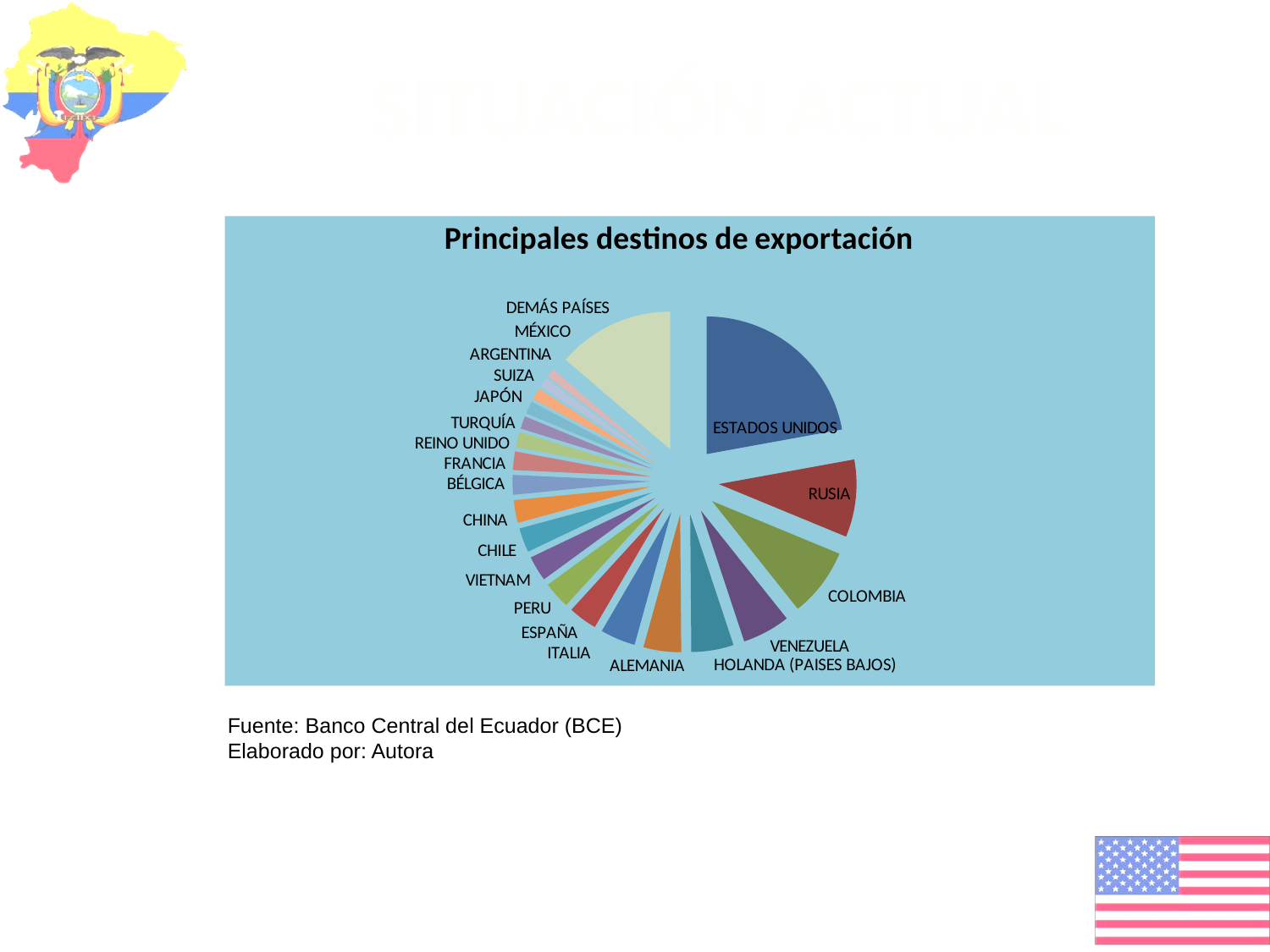
What kind of chart is shown on the slide? pie chart Which slice is larger, ESTADOS UNIDOS or COLOMBIA? ESTADOS UNIDOS How many slices (categories) does the pie chart have? 21 Which slice is larger, DEMÁS PAÍSES or RUSIA? DEMÁS PAÍSES What is the title of the chart? Principales destinos de exportación Which slice is larger, VENEZUELA or ARGENTINA? VENEZUELA What colour is the ESTADOS UNIDOS slice? blue Which category has the largest slice of the pie? ESTADOS UNIDOS